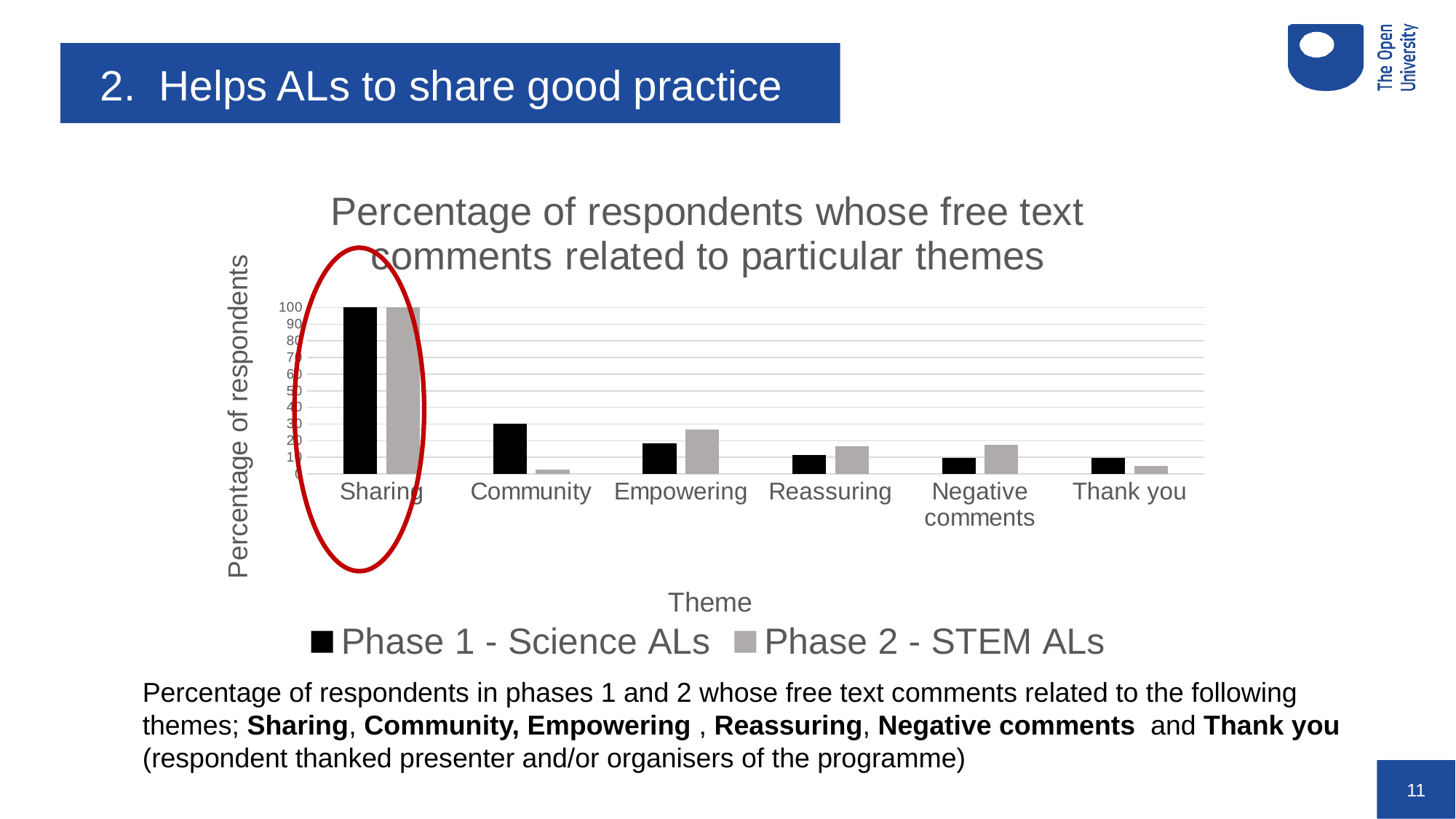
How many themes are shown on the x axis? 6 What is the label of the y axis? Percentage of respondents What kind of chart is shown on the slide? bar chart Which theme has the highest value for Phase 1 - Science ALs? Sharing Is the value for Community in the Phase 1 - Science ALs series greater or less than 20? greater For Negative comments, which series has the larger value, Phase 1 - Science ALs or Phase 2 - STEM ALs? Phase 2 - STEM ALs For Community, which series has the larger value, Phase 1 - Science ALs or Phase 2 - STEM ALs? Phase 1 - Science ALs What is the value for Sharing in the Phase 2 - STEM ALs series? 100 Which theme has the lowest value for Phase 2 - STEM ALs? Community How many series does the legend list? 2 What is the value for Sharing in the Phase 1 - Science ALs series? 100 Is the value for Empowering in the Phase 2 - STEM ALs series greater or less than 20? greater